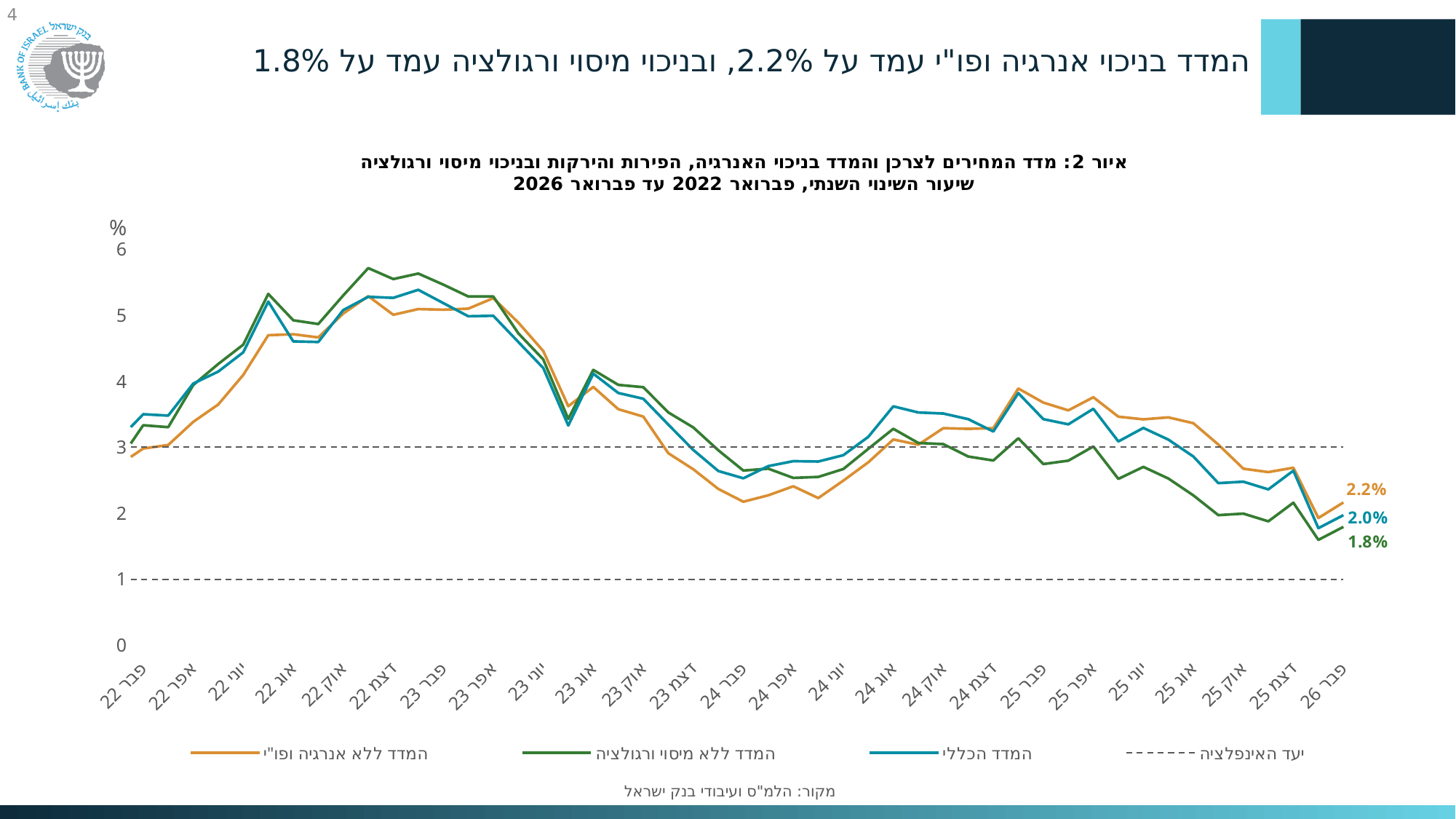
What is the difference between the final values of המדד ללא אנרגיה ופו"י (2.2%) and המדד הכללי (2.0%)? 0.2 percentage points Between פבר 25 and פבר 26, does המדד הכללי rise or fall overall? fall What is the value of המדד ללא מיסוי ורגולציה at the end of the series (פבר 26)? 1.8% What is the value of המדד הכללי at the end of the series (פבר 26)? 2.0% What is the value of המדד ללא אנרגיה ופו"י at the end of the series (פבר 26)? 2.2% At פבר 26, which series is higher: המדד ללא אנרגיה ופו"י or המדד ללא מיסוי ורגולציה? המדד ללא אנרגיה ופו"י What is the difference between the final values of המדד ללא אנרגיה ופו"י (2.2%) and המדד ללא מיסוי ורגולציה (1.8%)? 0.4 percentage points How many series does the legend list? 4 What kind of chart is shown on the slide? Line chart What does the dashed horizontal line in the chart represent, according to the legend? יעד האינפלציה Is the value for המדד הכללי at פבר 26 greater or less than 3? less Is the value for המדד הכללי at אוק 22 greater or less than 4? greater